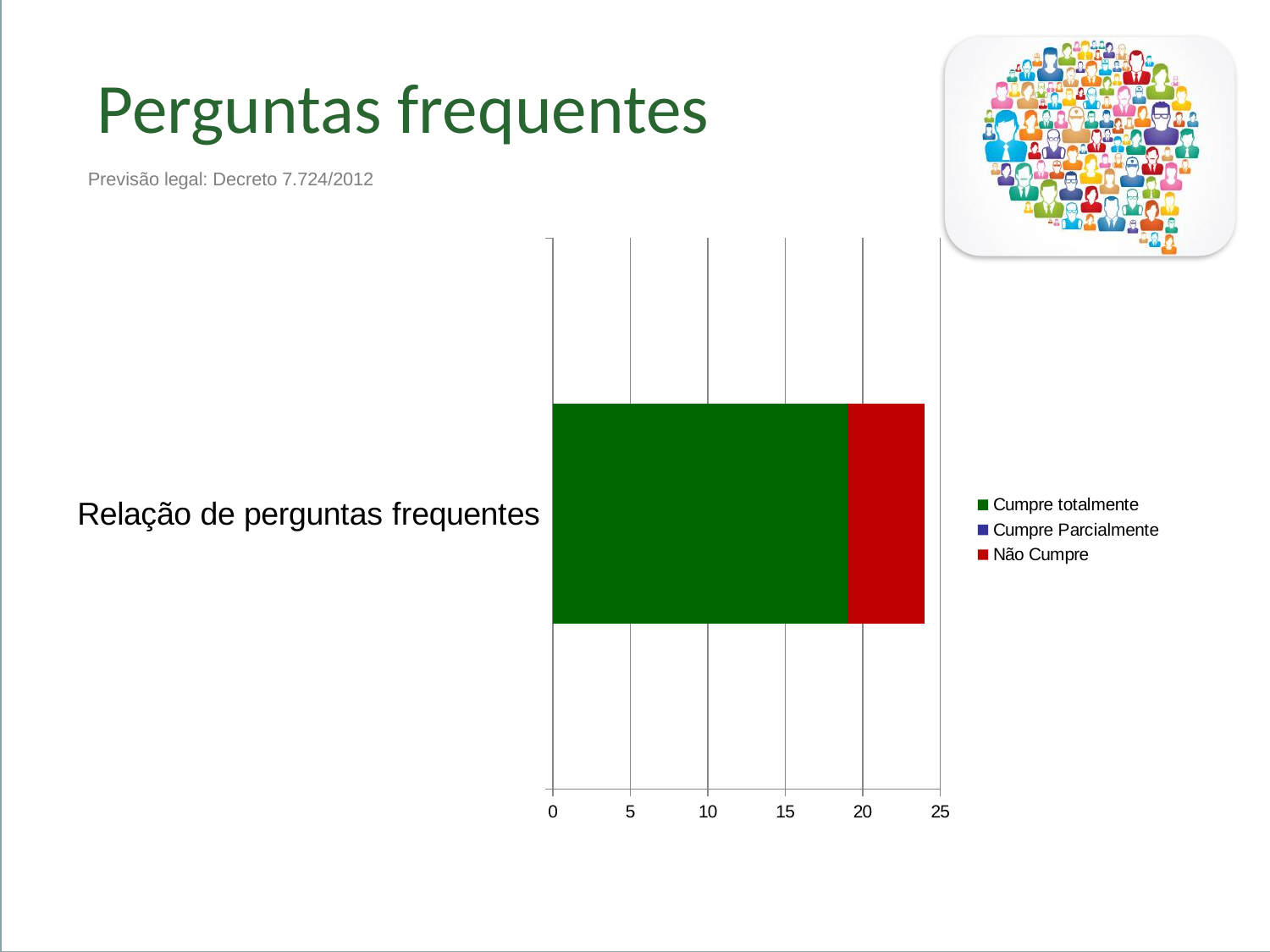
Which series has the largest segment in the bar for Relação de perguntas frequentes? Cumpre totalmente Is the value for Cumpre totalmente greater or less than 15? greater What kind of chart is shown on the slide? bar chart Is the total length of the stacked bar for Relação de perguntas frequentes greater or less than 20? greater What colour represents Não Cumpre in the chart? red What is the label of the category plotted on the chart? Relação de perguntas frequentes How many categories are plotted on the chart? 1 How many series does the chart legend list? 3 Is the value for Cumpre totalmente greater or less than 10? greater Which is larger for Relação de perguntas frequentes, Cumpre totalmente or Não Cumpre? Cumpre totalmente Which legend series has no visible segment in the bar? Cumpre Parcialmente